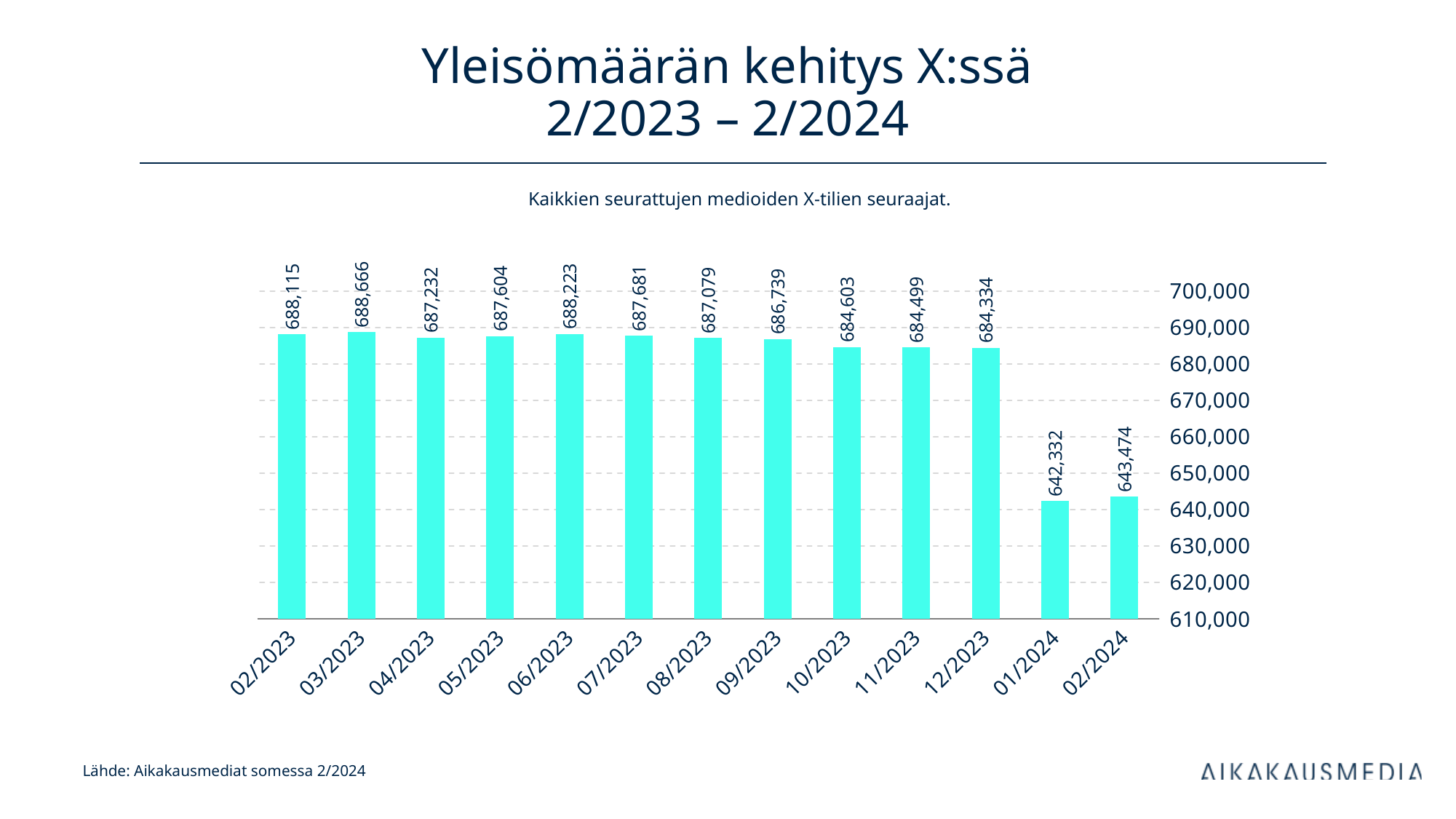
Which is larger, the value for 06/2023 or the value for 10/2023? 06/2023 What is the difference between the values for 02/2023 and 02/2024? 44,641 How many months are shown on the x axis? 13 What is the title of the chart? Yleisömäärän kehitys X:ssä 2/2023 – 2/2024 Which month has the highest value? 03/2023 What is the difference between the values for 12/2023 and 01/2024? 42,002 What is the value for 01/2024? 642,332 What is the value for 02/2023? 688,115 Is the value for 01/2024 greater or less than 650,000? less Which month has the lowest value? 01/2024 What kind of chart is shown on the slide? bar chart What is the value for 09/2023? 686,739